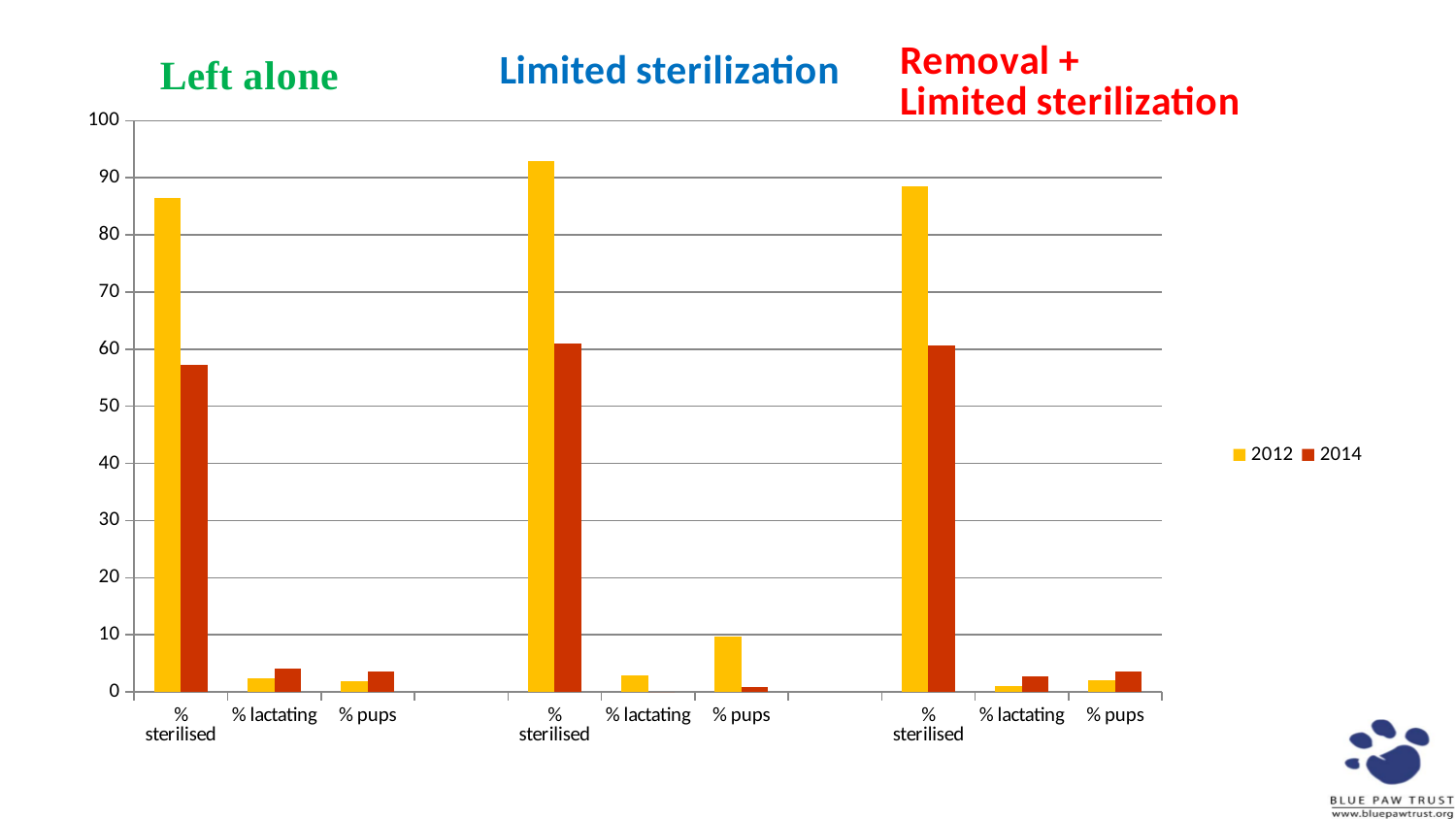
What colour represents the 2012 series in the chart? yellow In the Removal + Limited sterilization group, is the 2014 value for % sterilised greater or less than 50? greater In the Left alone group, is the 2012 value for % sterilised greater or less than 80? greater In the Limited sterilization group, which year has the larger % pups bar, 2012 or 2014? 2012 In the Left alone group, is the 2014 value for % sterilised greater or less than 60? less What are the two series named in the legend? 2012 and 2014 Across the three groups, which group has the tallest 2012 % sterilised bar? Limited sterilization How many group headings (panels) are shown above the chart? 3 What kind of chart is shown on the slide? bar chart In the Limited sterilization group, which year has the larger % sterilised bar, 2012 or 2014? 2012 How many series does the legend list? 2